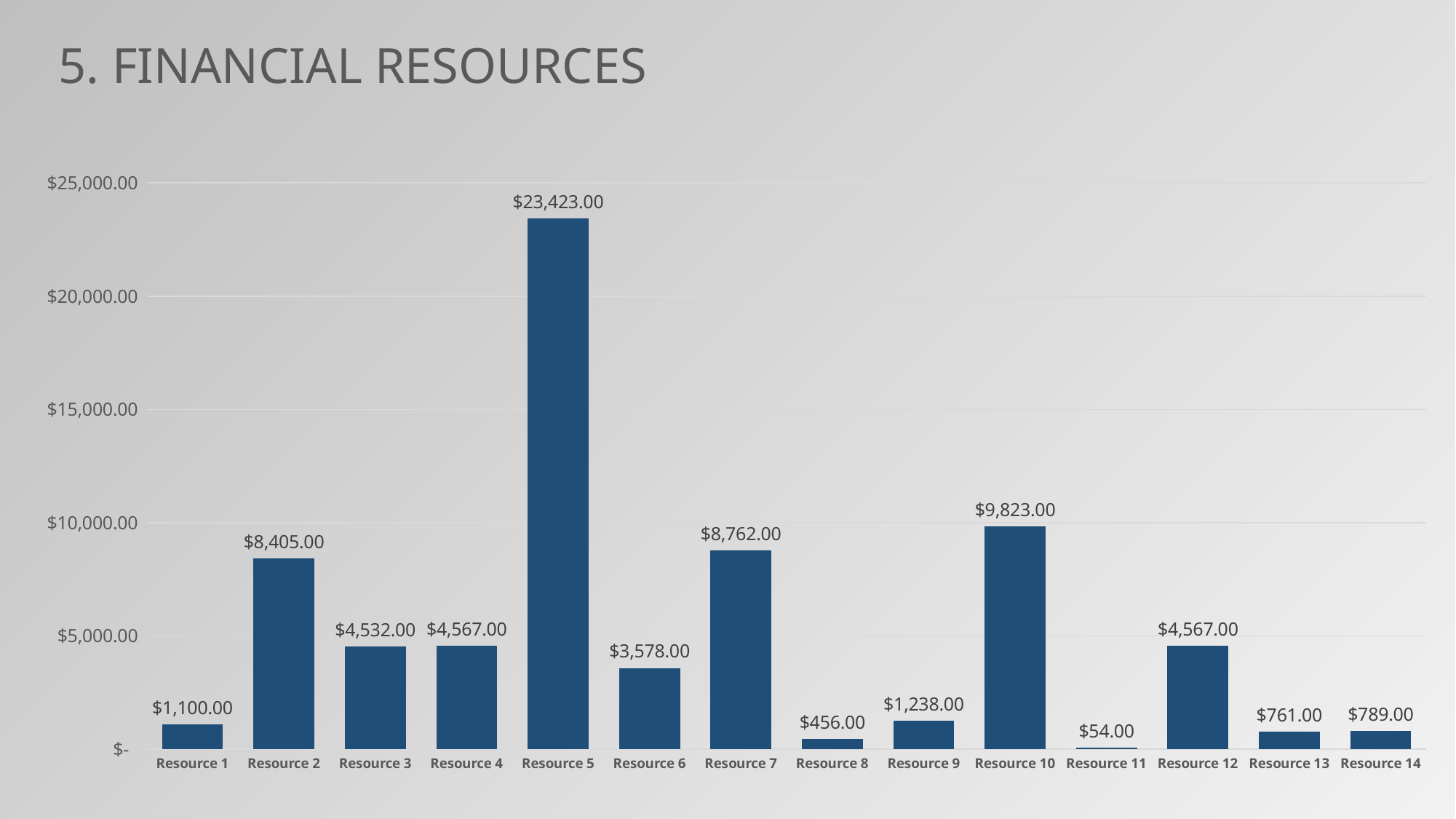
What is the difference between the values for Resource 10 and Resource 2? $1,418.00 What is the value for Resource 5? $23,423.00 What is the value for Resource 9? $1,238.00 Which is larger, the value for Resource 7 or the value for Resource 2? Resource 7 Which resource has the highest value? Resource 5 Which resource has the lowest value? Resource 11 What is the value for Resource 11? $54.00 What is the title of the slide? 5. FINANCIAL RESOURCES Is the value for Resource 10 greater or less than $10,000.00? less What is the difference between the values for Resource 14 and Resource 13? $28.00 What kind of chart is shown on the slide? bar chart How many resources are shown on the chart? 14